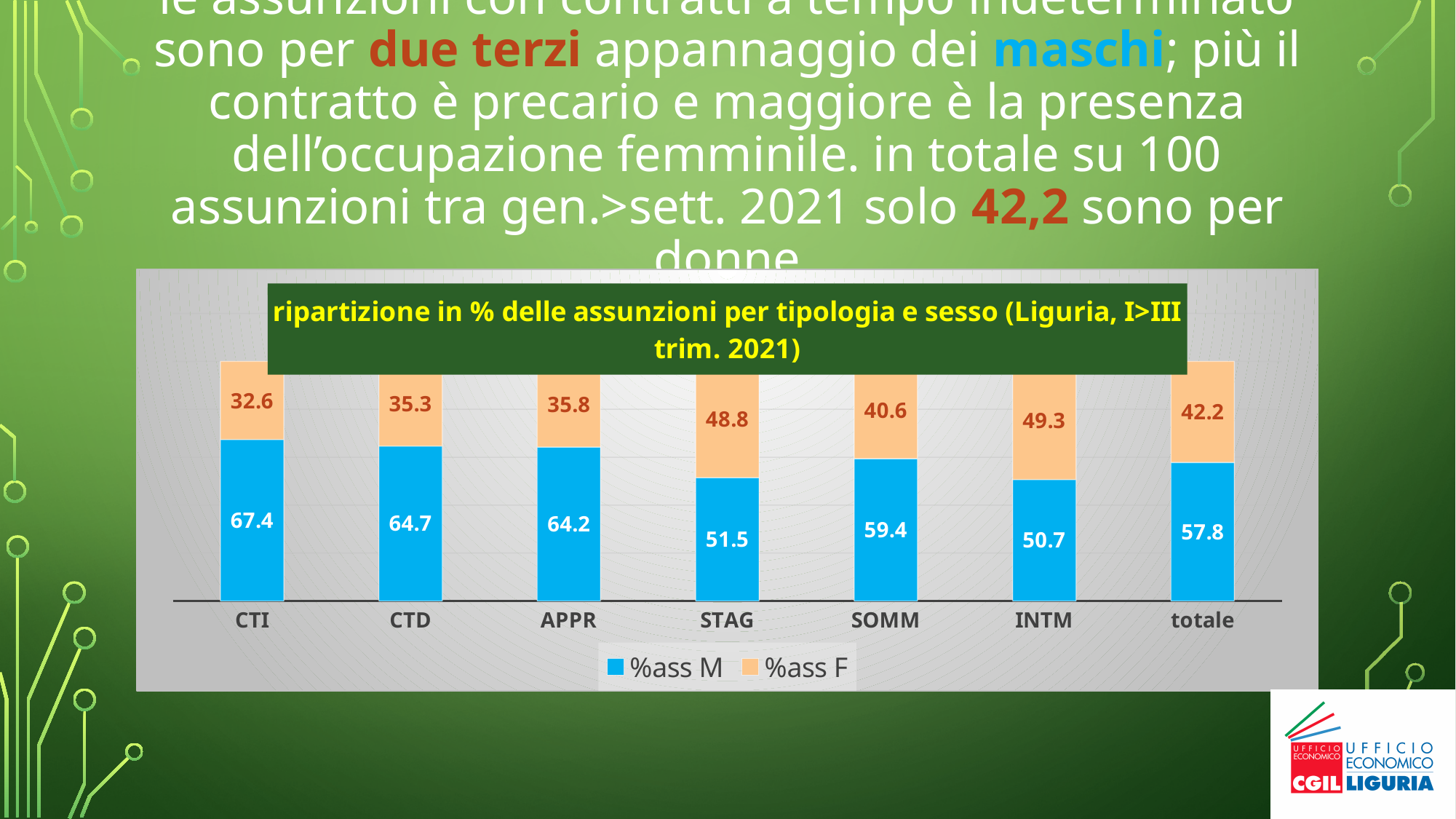
What is the total of the stacked bar for INTM? 100 What is the difference between the %ass M and %ass F values for SOMM? 18.8 Which category has the highest %ass F value? INTM Which category has the highest %ass M value? CTI Which category has the lowest %ass M value? INTM What is the %ass M value for CTI? 67.4 How many categories are shown on the x axis? 7 What is the %ass M value for the totale category? 57.8 What is the %ass F value for STAG? 48.8 Which is larger, the %ass F value for CTD or the %ass F value for APPR? APPR How many series does the legend list? 2 What kind of chart is shown on the slide? Stacked bar chart